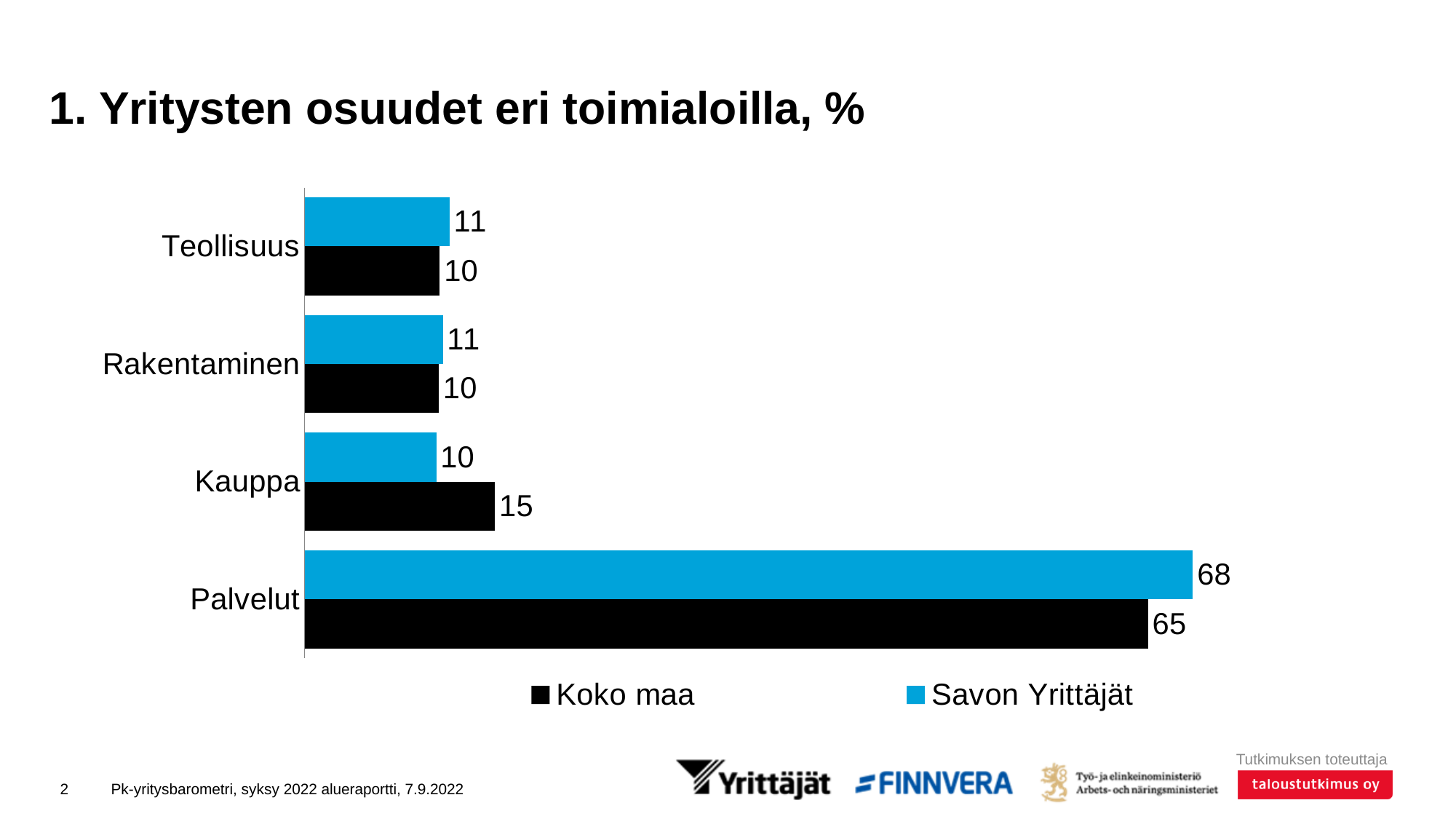
In the Kauppa category, which series has the larger value, Koko maa or Savon Yrittäjät? Koko maa What is the difference between the Koko maa and Savon Yrittäjät values for Kauppa? 5 What is the difference between the Savon Yrittäjät and Koko maa values for Palvelut? 3 How many categories are shown on the chart? 4 What is the value for Koko maa in the Kauppa category? 15 What is the value for Savon Yrittäjät in the Palvelut category? 68 What kind of chart is shown on the slide? Bar chart How many series does the legend list? 2 Which category has the highest value for Koko maa? Palvelut What is the value for Savon Yrittäjät in the Rakentaminen category? 11 What is the value for Koko maa in the Teollisuus category? 10 Which category has the lowest value for Savon Yrittäjät? Kauppa